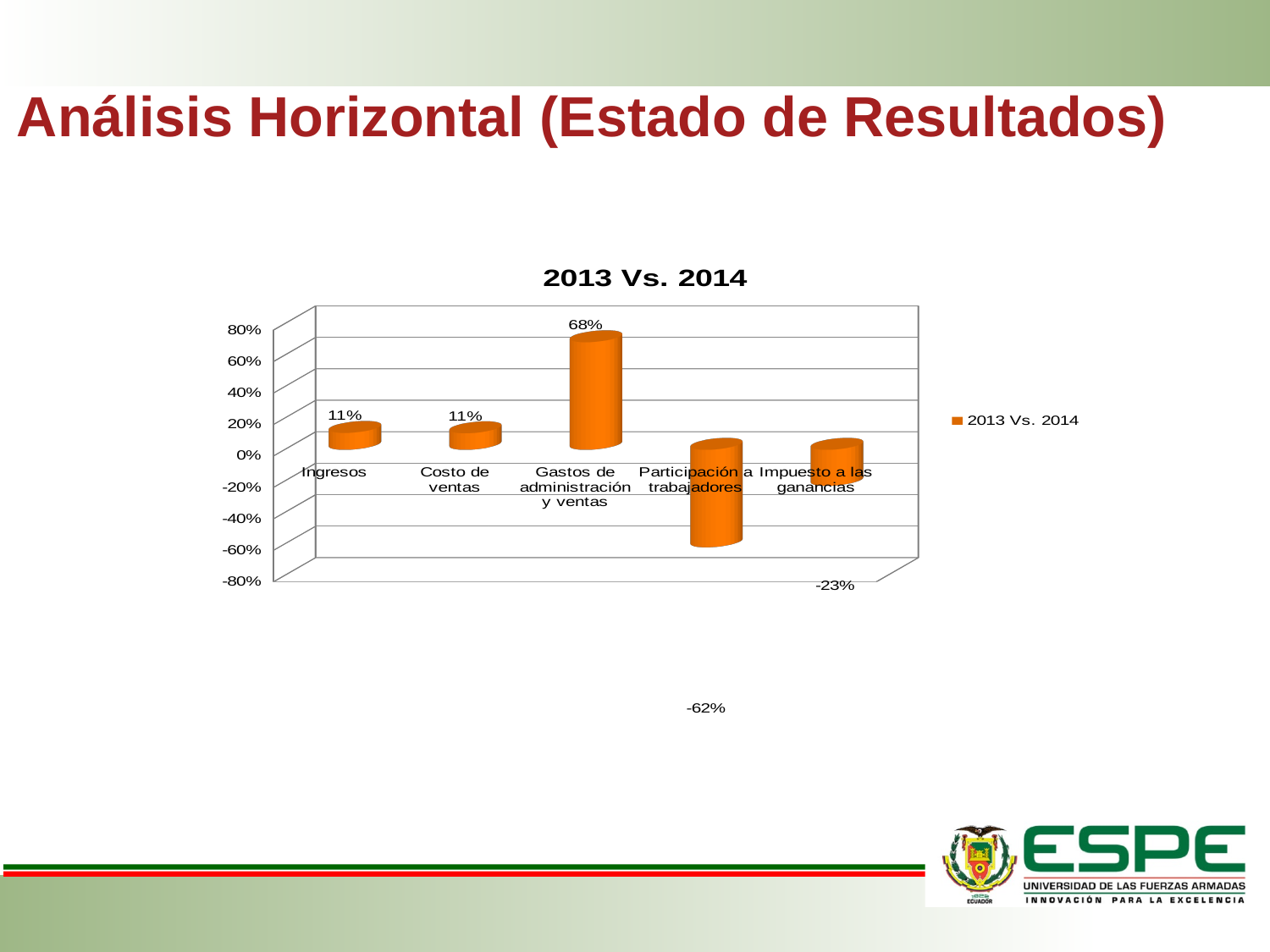
What is the difference between the values for Gastos de administración y ventas and Costo de ventas? 57% How many categories are shown on the x axis of the 2013 Vs. 2014 chart? 5 What is the value for Participación a trabajadores in the 2013 Vs. 2014 chart? -62% Which category has the highest value in the 2013 Vs. 2014 chart? Gastos de administración y ventas Which is larger, the value for Impuesto a las ganancias or the value for Participación a trabajadores? Impuesto a las ganancias What is the value for Impuesto a las ganancias in the 2013 Vs. 2014 chart? -23% How many series does the legend of the chart list? 1 What kind of chart is shown on the slide? Bar chart Which category has the lowest value in the 2013 Vs. 2014 chart? Participación a trabajadores What is the value for Ingresos in the 2013 Vs. 2014 chart? 11% What is the title of the chart on the slide? 2013 Vs. 2014 What is the value for Gastos de administración y ventas in the 2013 Vs. 2014 chart? 68%